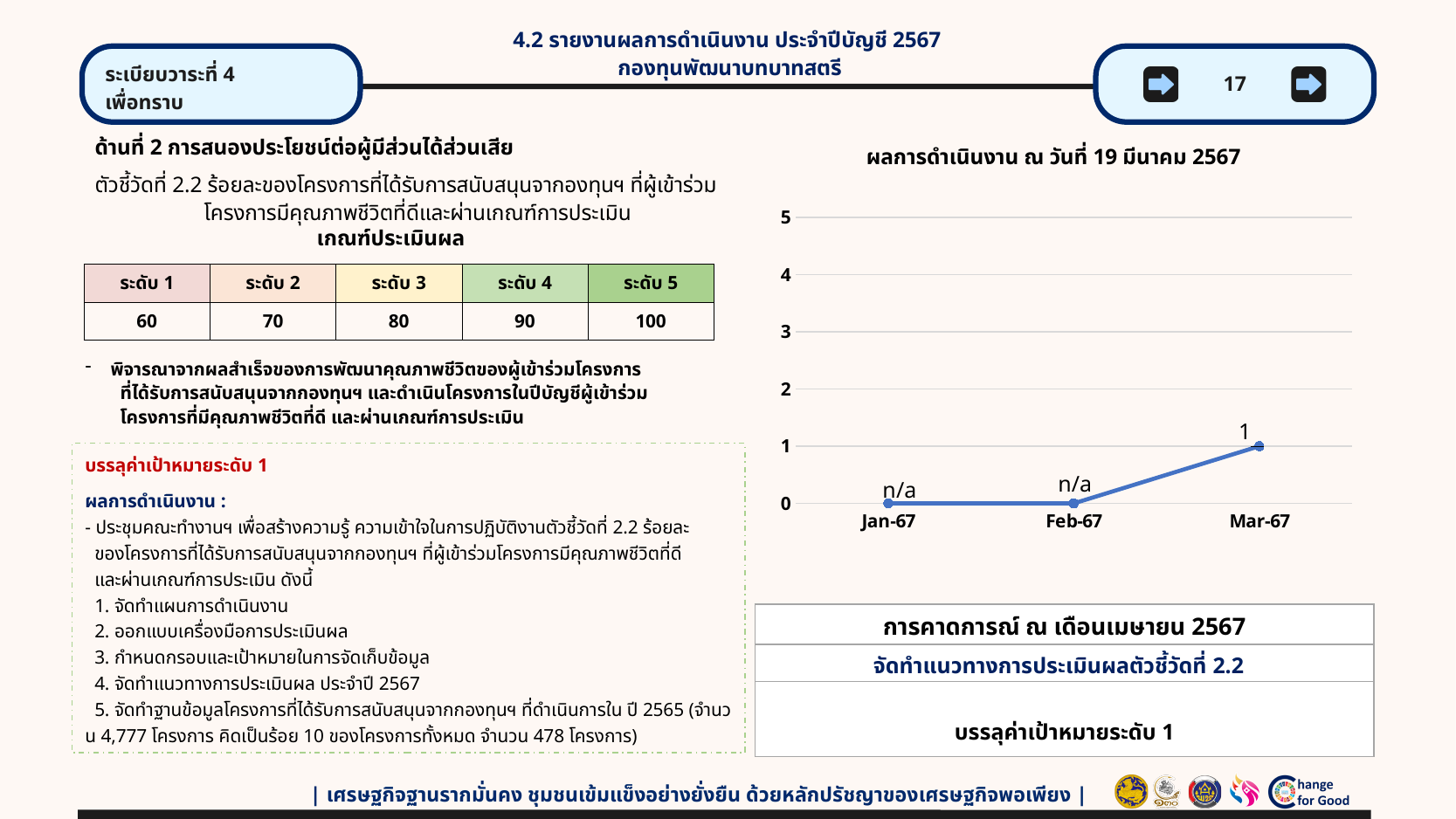
What is the data label shown for Mar-67 in the chart? 1 Is the value for Mar-67 greater or less than 2? less What type of chart is shown on the slide? line chart Does the line rise or fall from Feb-67 to Mar-67? rise What is the data label shown for Feb-67 in the chart? n/a What is the label of the first category on the x axis of the chart? Jan-67 What is the data label shown for Jan-67 in the chart? n/a Which month has the highest plotted value in the chart? Mar-67 What is the title of the chart? ผลการดำเนินงาน ณ วันที่ 19 มีนาคม 2567 How many points (months) are plotted along the x axis of the chart? 3 What is the highest value shown on the y axis of the chart? 5